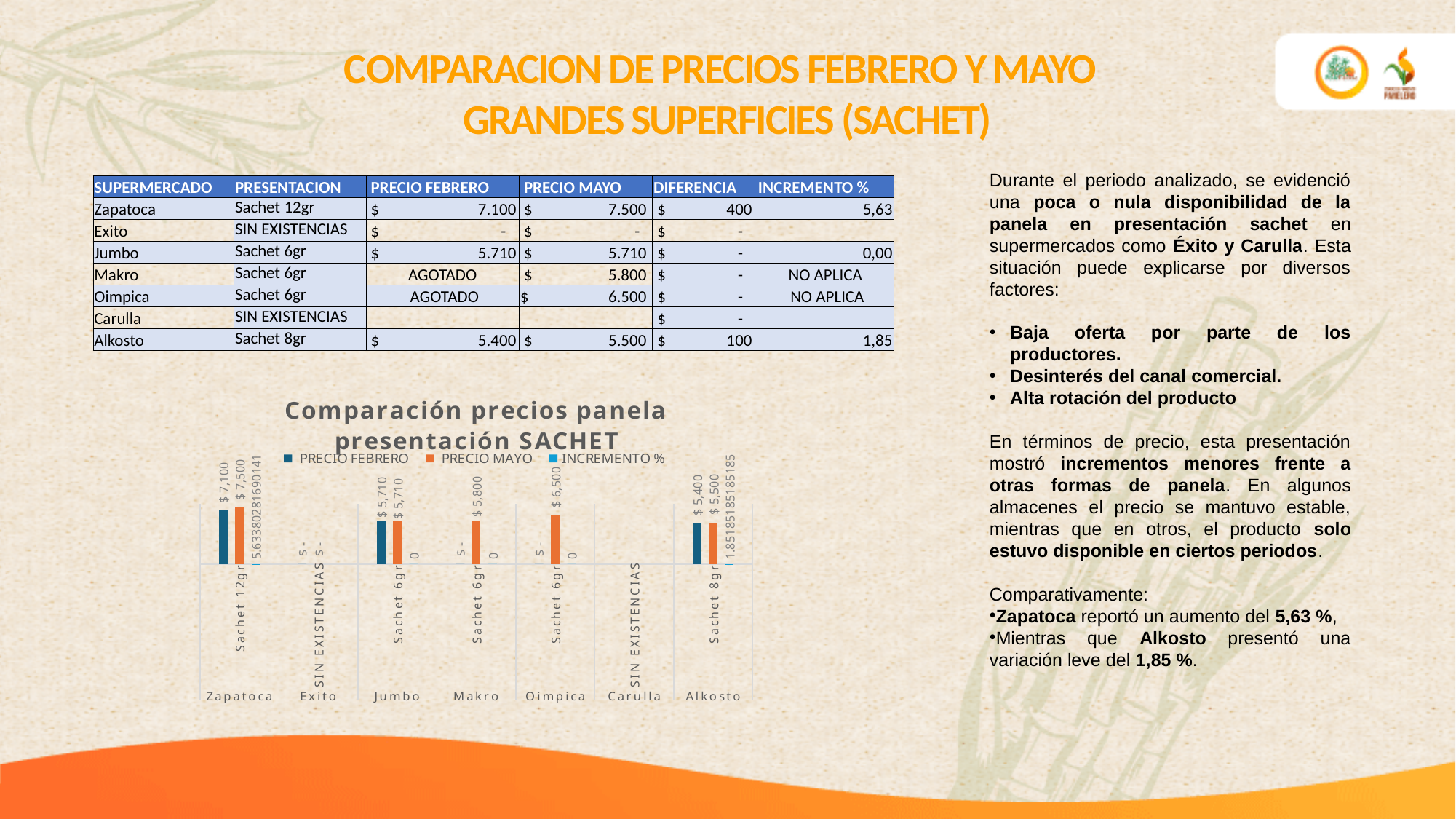
What is the PRECIO FEBRERO value for Jumbo in the chart? $ 5,710 What is the PRECIO MAYO value for Zapatoca in the chart? $ 7,500 What is the PRECIO MAYO value for Oimpica in the chart? $ 6,500 How many supermarket categories are shown on the chart's x axis? 7 What is the PRECIO MAYO value for Makro in the chart? $ 5,800 How many series does the chart legend list? 3 What type of chart is shown on the slide? bar chart Which supermarket has the lowest non-zero PRECIO FEBRERO bar in the chart? Alkosto Which is larger in the chart: the PRECIO MAYO for Zapatoca or the PRECIO MAYO for Oimpica? Zapatoca What is the title of the chart? Comparación precios panela presentación SACHET Which supermarket has the highest PRECIO MAYO bar in the chart? Zapatoca What is the difference between PRECIO MAYO and PRECIO FEBRERO for Alkosto in the chart? $ 100